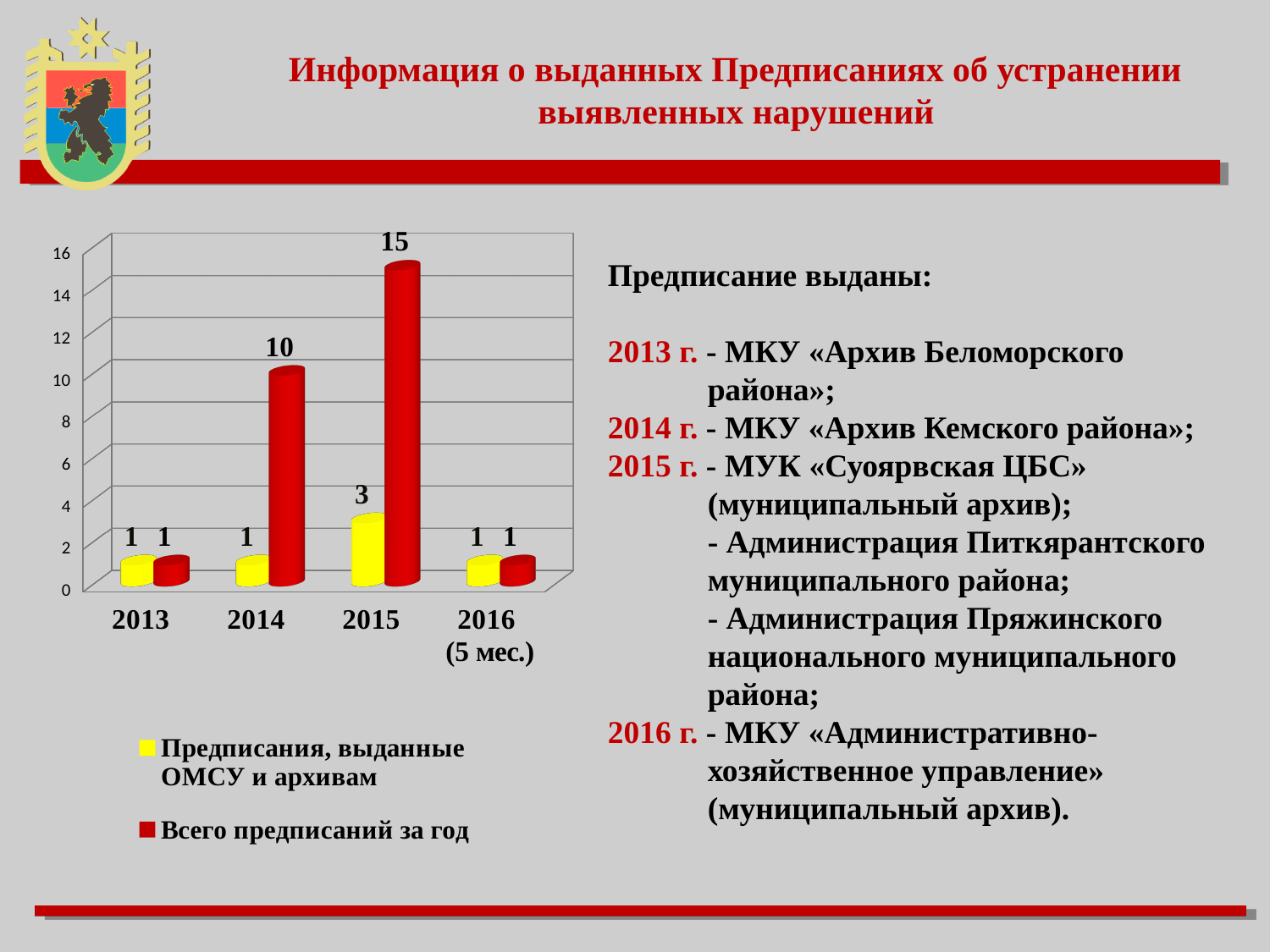
Какого типа эта диаграмма? Столбчатая (bar chart) В каком году значение ряда «Всего предписаний за год» наибольшее? 2015 Сколько категорий (лет) показано на оси x диаграммы? 4 Какое значение ряда «Всего предписаний за год» показано для 2014 года? 10 Какое значение ряда «Всего предписаний за год» показано для 2015 года? 15 На сколько значение «Всего предписаний за год» в 2015 году больше значения «Предписания, выданные ОМСУ и архивам» в том же году? 12 Какое значение ряда «Предписания, выданные ОМСУ и архивам» показано для 2015 года? 3 Какое значение ряда «Предписания, выданные ОМСУ и архивам» показано для 2016 года (5 мес.)? 1 Что больше: «Всего предписаний за год» в 2014 году или в 2016 году (5 мес.)? 2014 Сколько рядов данных перечислено в легенде диаграммы? 2 В каком году значение ряда «Предписания, выданные ОМСУ и архивам» наибольшее? 2015 На сколько значение «Всего предписаний за год» в 2015 году больше, чем в 2014 году? 5